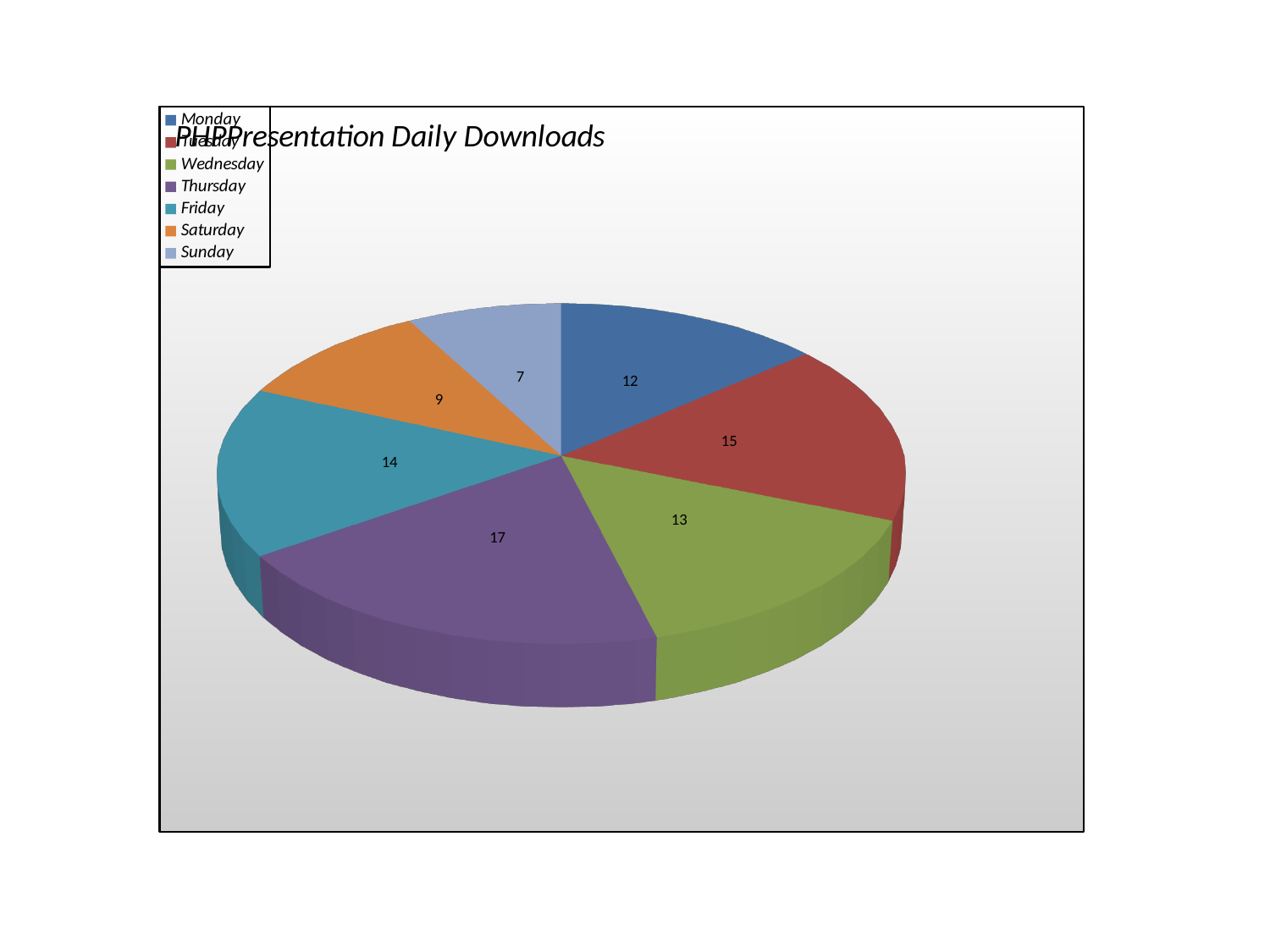
What is the value for Thursday? 17 What is the title of the chart? PHPPresentation Daily Downloads How many slices does the pie chart have? 7 Which day has the largest slice of the pie? Thursday What is the value for Saturday? 9 What is the value for Sunday? 7 What is the difference between the values for Thursday and Sunday? 10 Which day has the smallest slice of the pie? Sunday What is the difference between the values for Tuesday and Monday? 3 What type of chart is shown on the slide? Pie chart What is the value for Tuesday? 15 Which is larger, the value for Friday or the value for Wednesday? Friday